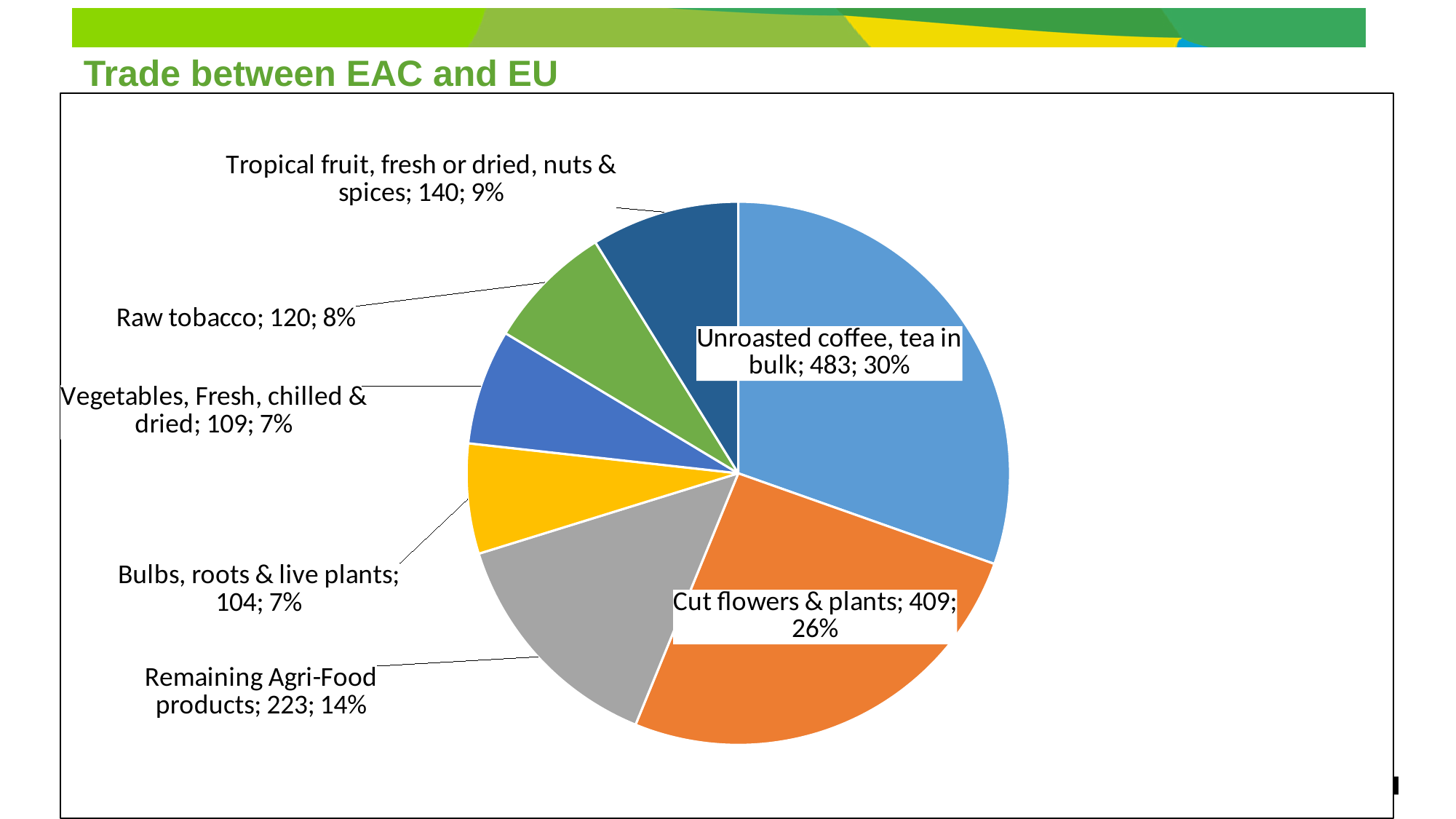
How many categories are shown in the pie chart? 7 What is the difference between the values for Unroasted coffee, tea in bulk and Cut flowers & plants? 74 What is the value for Cut flowers & plants? 409 What is the value for Remaining Agri-Food products? 223 Which is larger, the value for Raw tobacco or the value for Vegetables, Fresh, chilled & dried? Raw tobacco What is the value for Unroasted coffee, tea in bulk? 483 Which category has the smallest slice of the pie? Bulbs, roots & live plants Which category has the largest slice of the pie? Unroasted coffee, tea in bulk What share of the pie does Tropical fruit, fresh or dried, nuts & spices represent? 9% What kind of chart is shown on the slide? pie chart What is the value for Raw tobacco? 120 What share of the pie does Remaining Agri-Food products represent? 14%